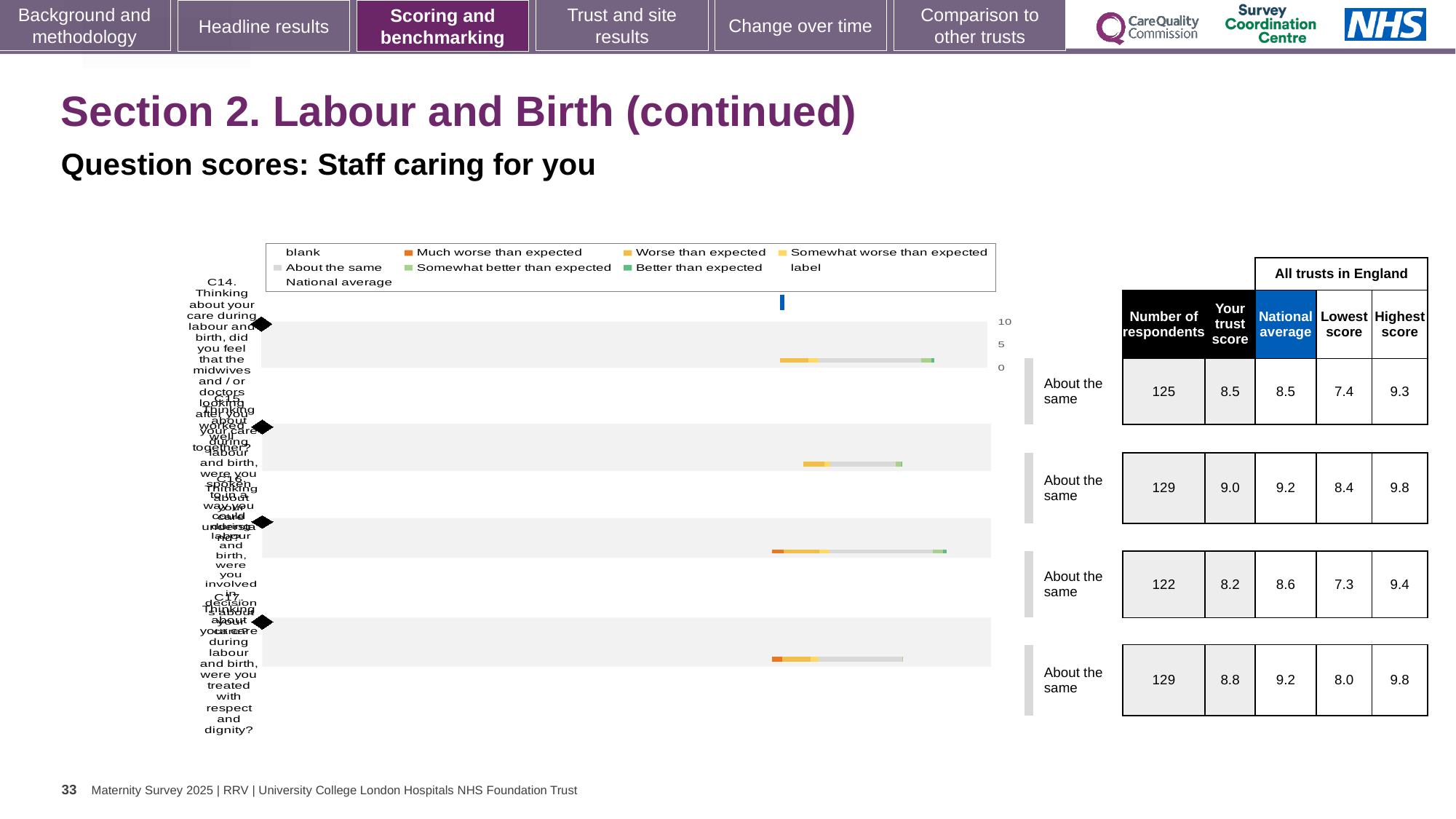
In the table beside the chart, what is the 'National average' for the second row (129 respondents, trust score 9.0)? 9.2 For the fourth row (trust score 8.8), what is the difference between the 'Highest score' and the 'Lowest score'? 1.8 In the table beside the chart, what is the 'Lowest score' for the third row (122 respondents)? 7.3 How many question rows (bars) are plotted in the chart? 4 What kind of chart is shown on the slide? bar chart Which row has the highest 'Your trust score' in the table? the second row (9.0) What colour does the legend use for 'Much worse than expected'? orange For the third row (122 respondents), which is larger: 'Your trust score' or the 'National average'? National average What benchmark label is shown for every question row on this slide? About the same In the table beside the chart, what is 'Your trust score' for the first row (125 respondents)? 8.5 How many entries does the chart legend list? 9 What is the highest tick value shown on the chart's axis? 10